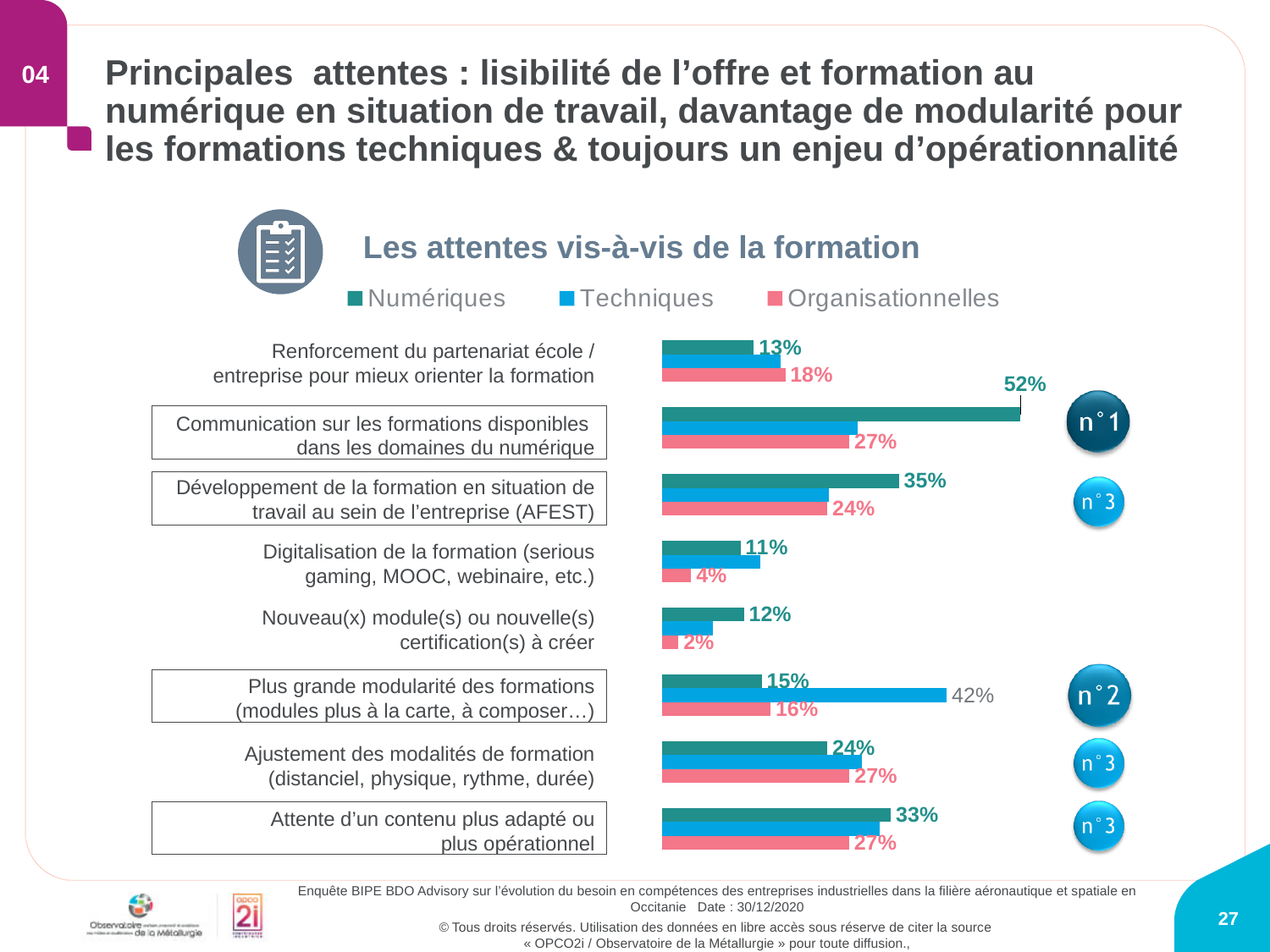
What is the Techniques value for 'Plus grande modularité des formations'? 42% For 'Communication sur les formations disponibles dans les domaines du numérique', what is the difference between the Numériques and Organisationnelles values? 25 percentage points Which category has the highest Numériques value? Communication sur les formations disponibles dans les domaines du numérique What is the Organisationnelles value for 'Digitalisation de la formation (serious gaming, MOOC, webinaire, etc.)'? 4% How many series does the legend of the chart list? 3 How many categories (expectations) are plotted in the chart? 8 Which category has the lowest Organisationnelles value? Nouveau(x) module(s) ou nouvelle(s) certification(s) à créer What kind of chart is shown on the slide? Bar chart For 'Attente d'un contenu plus adapté ou plus opérationnel', which is larger: the Numériques value or the Organisationnelles value? Numériques What is the Numériques value for 'Développement de la formation en situation de travail au sein de l'entreprise (AFEST)'? 35% What is the title of the chart? Les attentes vis-à-vis de la formation What is the Numériques value for 'Communication sur les formations disponibles dans les domaines du numérique'? 52%